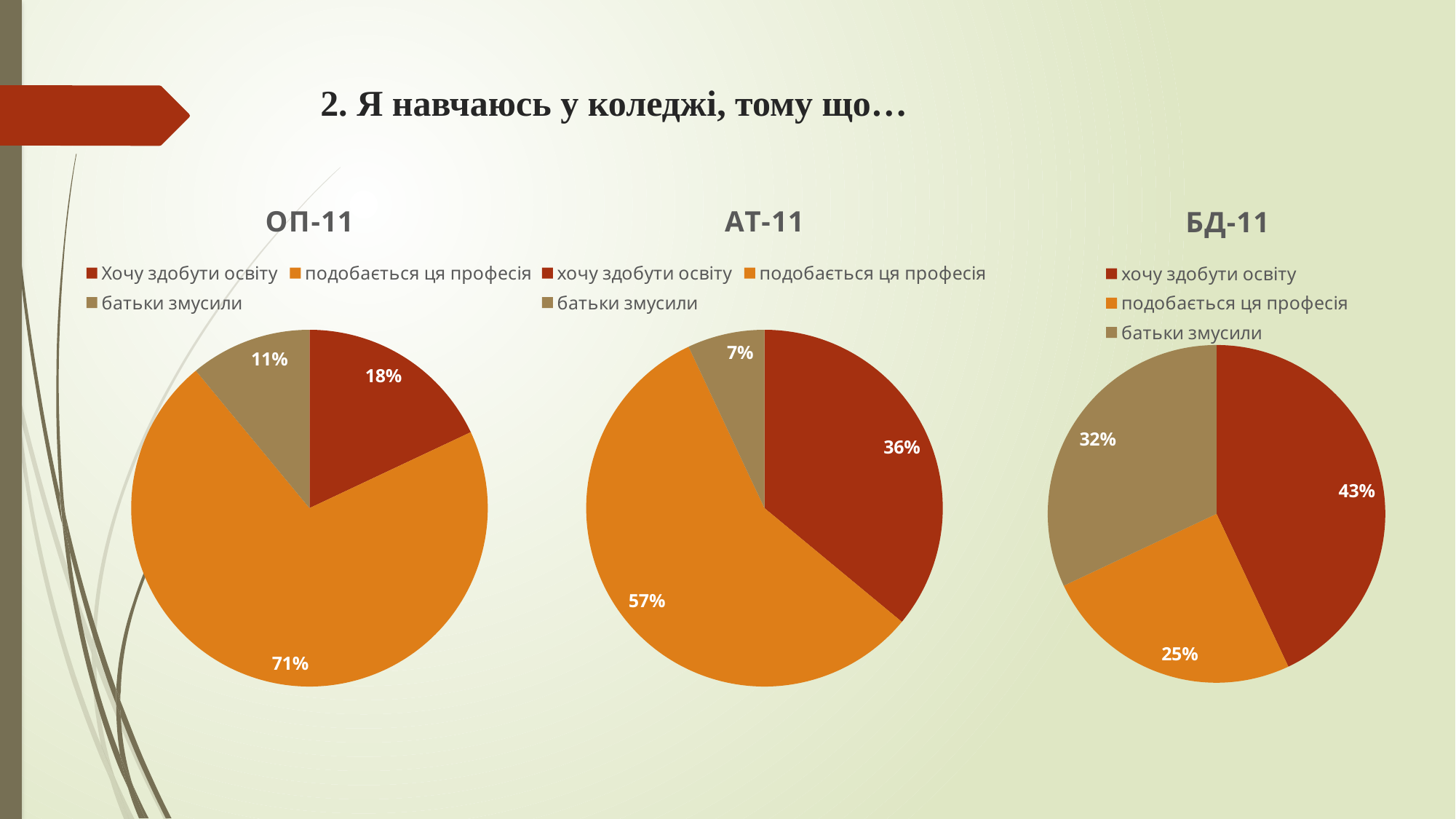
In the БД-11 chart, what share is labelled for 'батьки змусили'? 32% How many slices does the АТ-11 chart have? 3 What type of chart is the ОП-11 chart? pie chart In the ОП-11 chart, what is the difference between the 'подобається ця професія' slice and the 'Хочу здобути освіту' slice? 53% What is the title of the chart on the right of the slide? БД-11 In the АТ-11 chart, which category has the smallest slice? батьки змусили In the ОП-11 chart, what share is labelled for 'подобається ця професія'? 71% In the БД-11 chart, which is larger: 'подобається ця професія' or 'батьки змусили'? батьки змусили How many entries does the legend of the БД-11 chart list? 3 In the АТ-11 chart, what share is labelled for 'хочу здобути освіту'? 36% In the ОП-11 chart, what share is labelled for 'батьки змусили'? 11% In the БД-11 chart, which category has the largest slice? хочу здобути освіту